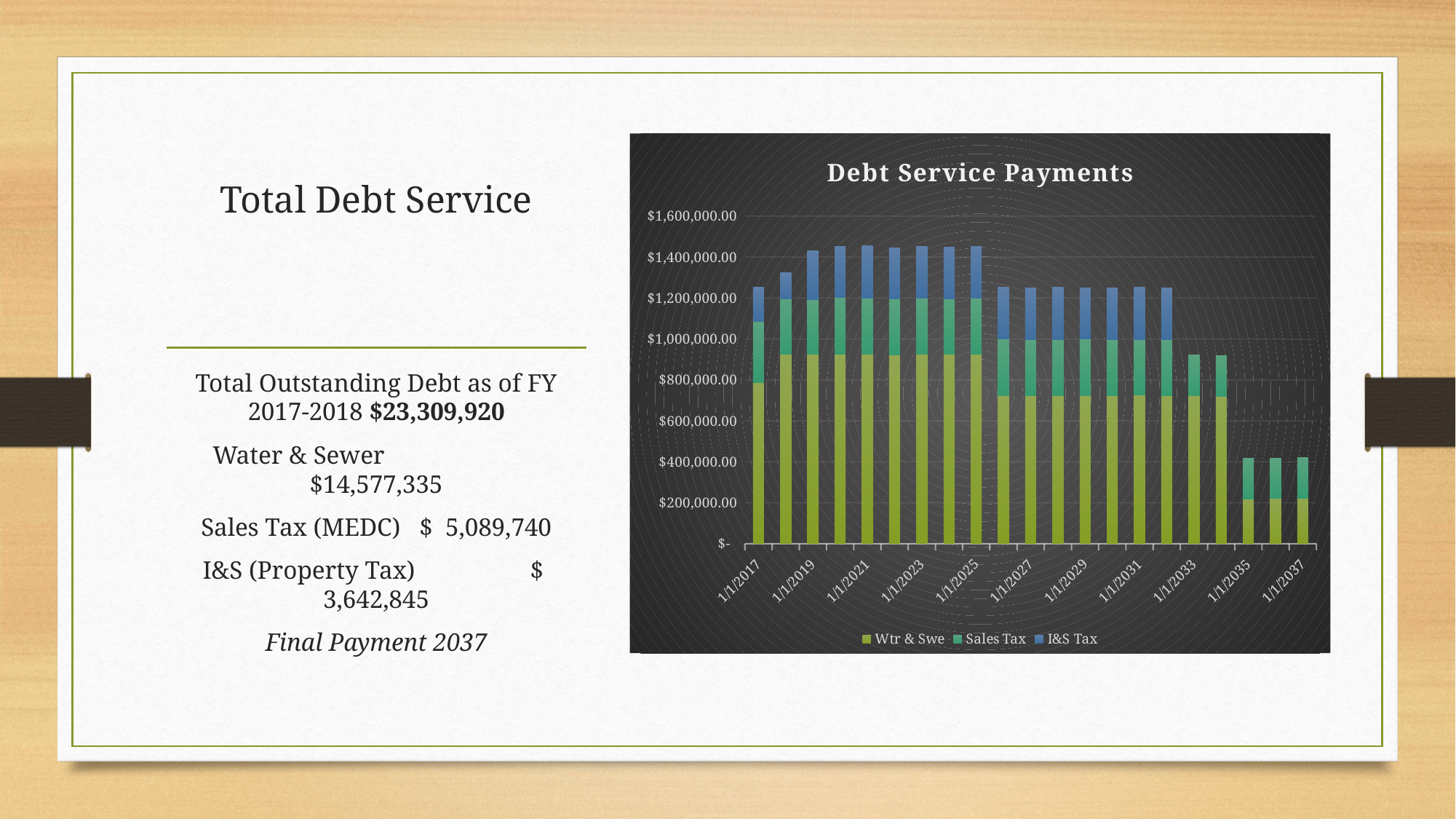
Is the total debt service payment for 1/1/2017 greater or less than $1,000,000.00? greater Do the total debt service payments rise or fall from 1/1/2025 to 1/1/2037? fall How many bars are plotted in the chart? 21 How many series does the chart legend list? 3 Which year has the larger total debt service payment, 1/1/2021 or 1/1/2037? 1/1/2021 Which series is shown in blue in the chart? I&S Tax Is the total debt service payment for 1/1/2033 greater or less than $1,000,000.00? less Which year has the larger total debt service payment, 1/1/2017 or 1/1/2019? 1/1/2019 Is the total debt service payment for 1/1/2037 greater or less than $600,000.00? less What is the title of the chart? Debt Service Payments What type of chart is shown on the slide? Stacked bar chart